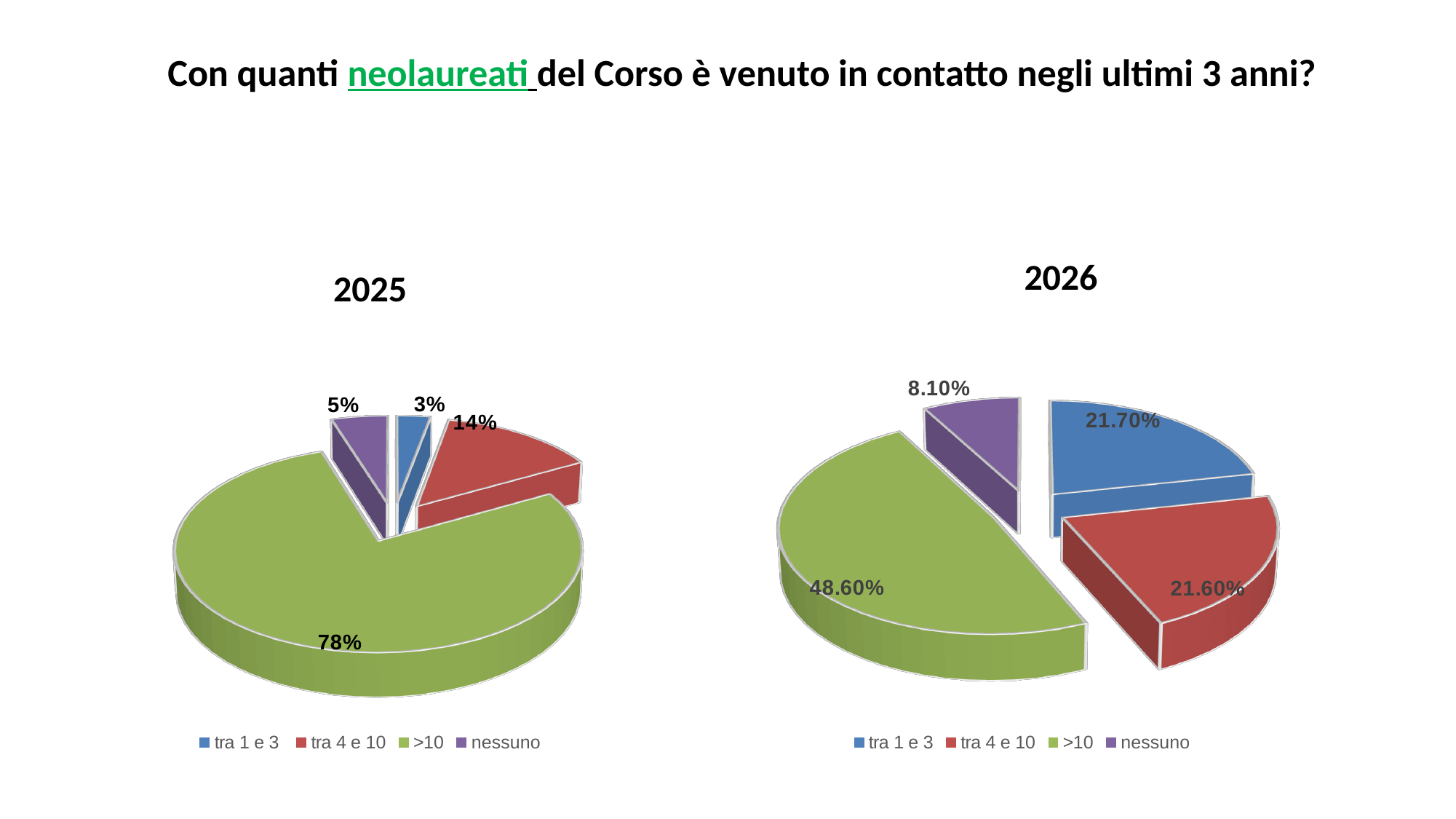
In the 2026 chart, what share is labelled for the 'nessuno' slice? 8.10% In the 2025 chart, what is the difference between the '>10' share and the 'tra 4 e 10' share? 64% In the 2026 chart, what share is labelled for the 'tra 1 e 3' slice? 21.70% How many slices does the 2026 pie chart have? 4 In the 2026 chart, what is the difference between the '>10' share and the 'nessuno' share? 40.50% In the 2026 chart, which category has the largest slice? >10 What type of chart is used for the 2025 data? Pie chart In the 2025 chart, which is larger: the 'nessuno' slice or the 'tra 1 e 3' slice? nessuno In the 2025 chart, which category has the smallest slice? tra 1 e 3 In the 2025 chart, what share is labelled for the 'tra 4 e 10' slice? 14% In the 2026 chart, which colour represents the '>10' category? Green In the 2025 chart, what share is labelled for the '>10' slice? 78%